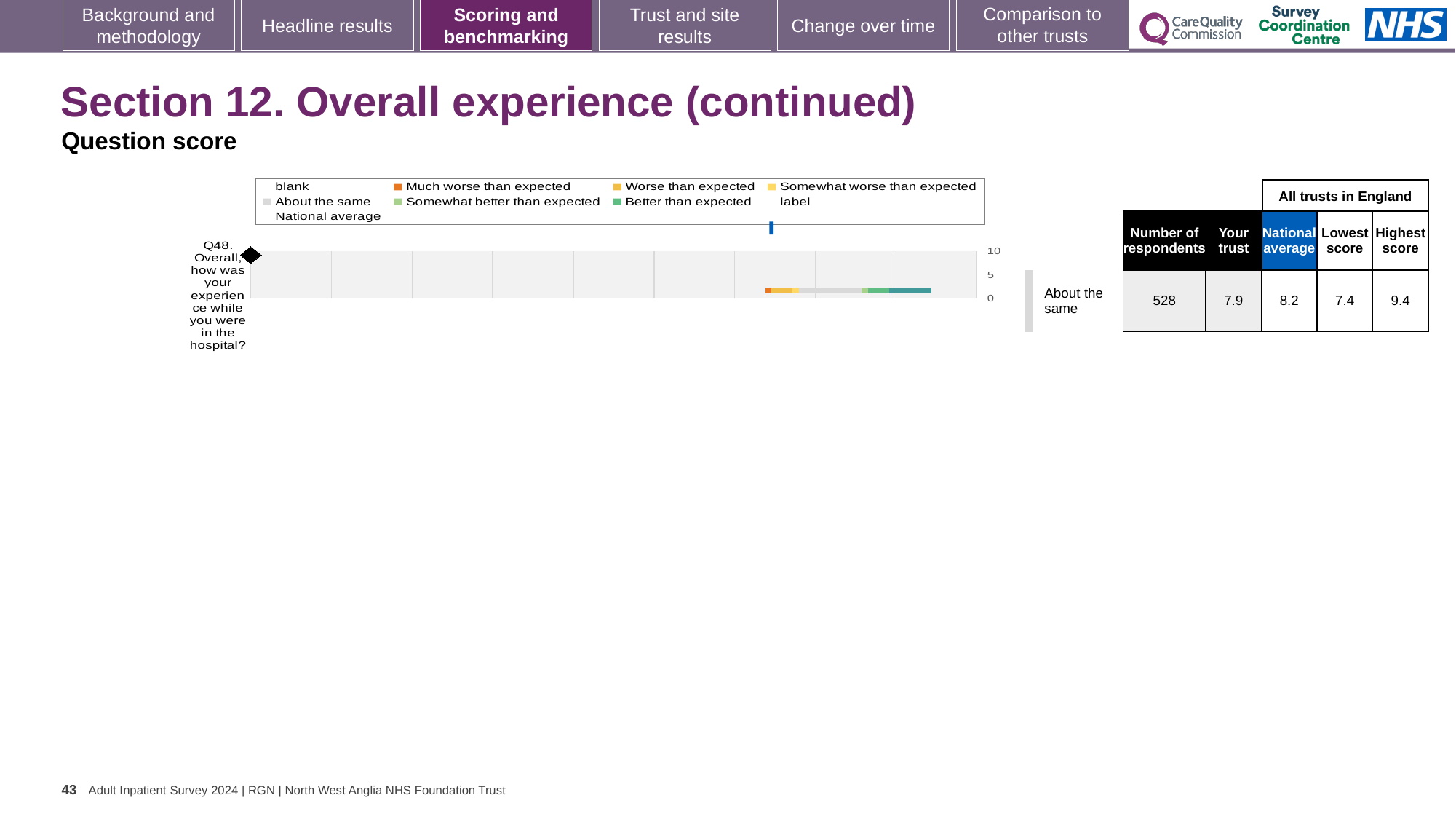
What kind of chart is used to show the Q48 question score? bar chart What is the 'Your trust' score for Q48? 7.9 What is the national average score for Q48? 8.2 What benchmark category is shown next to the chart for Q48? About the same How many questions are plotted in the chart? 1 Which question is plotted in the chart? Q48. Overall, how was your experience while you were in the hospital? What is the highest score among all trusts in England for Q48? 9.4 Is the 'Your trust' score for Q48 greater or less than 5? greater What is the lowest score among all trusts in England for Q48? 7.4 What is the difference between the highest score and the lowest score for Q48? 2.0 Which is larger for Q48, the 'Your trust' score or the national average? National average How many respondents answered Q48? 528